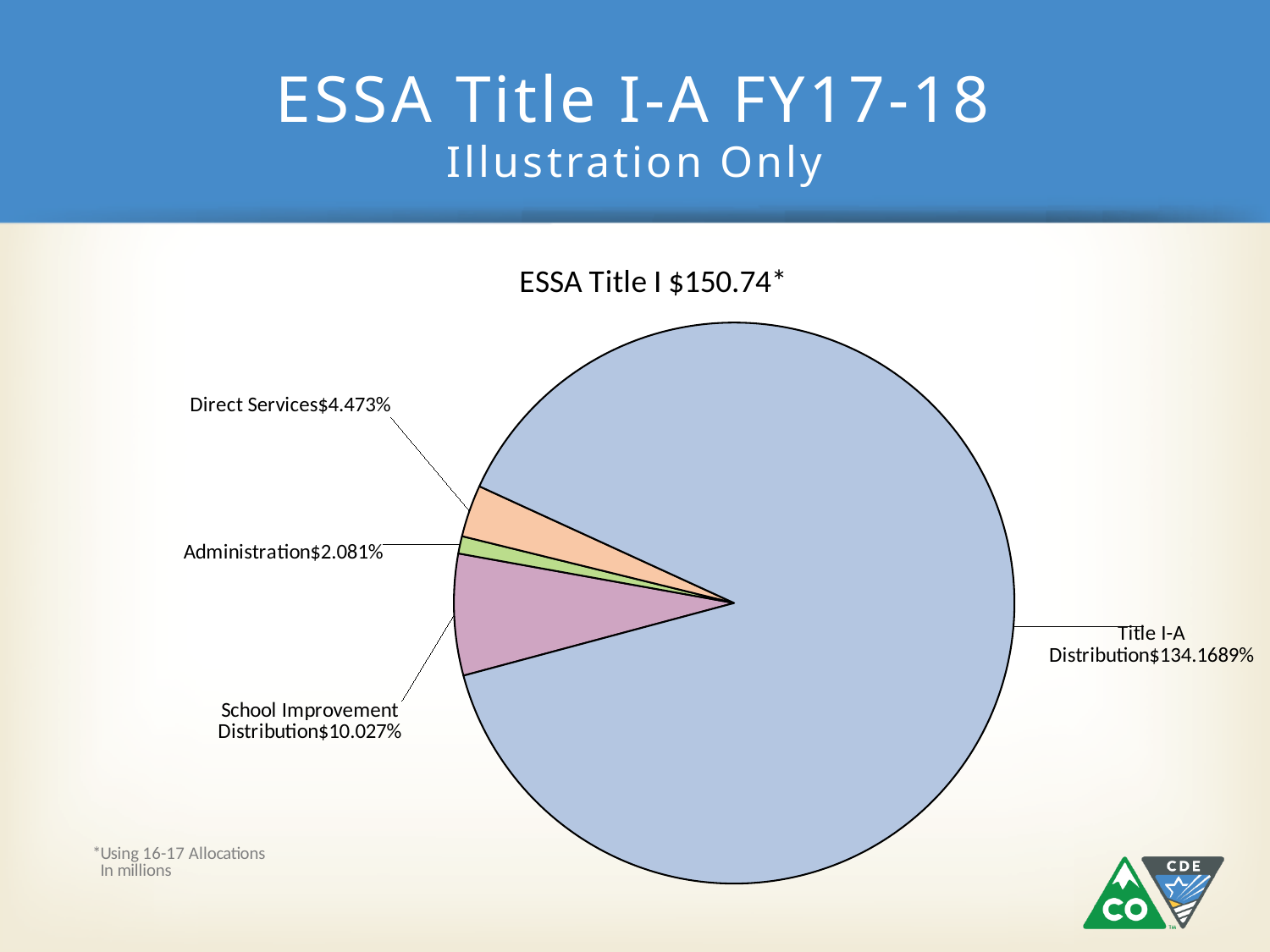
What value is labelled for the School Improvement Distribution slice? $10.027% Which is larger, the School Improvement Distribution slice or the Direct Services slice? School Improvement Distribution What value is labelled for the Administration slice? $2.081% How many slices does the pie chart have? 4 What value is labelled for the Direct Services slice? $4.473% What type of chart is shown on the slide? pie chart What is the title of the pie chart? ESSA Title I $150.74* What value is labelled for the Title I-A Distribution slice? $134.1689% Which slice of the pie chart is the smallest? Administration Which slice of the pie chart is the largest? Title I-A Distribution Which is larger, the Direct Services slice or the Administration slice? Direct Services What colour is the Title I-A Distribution slice? light blue